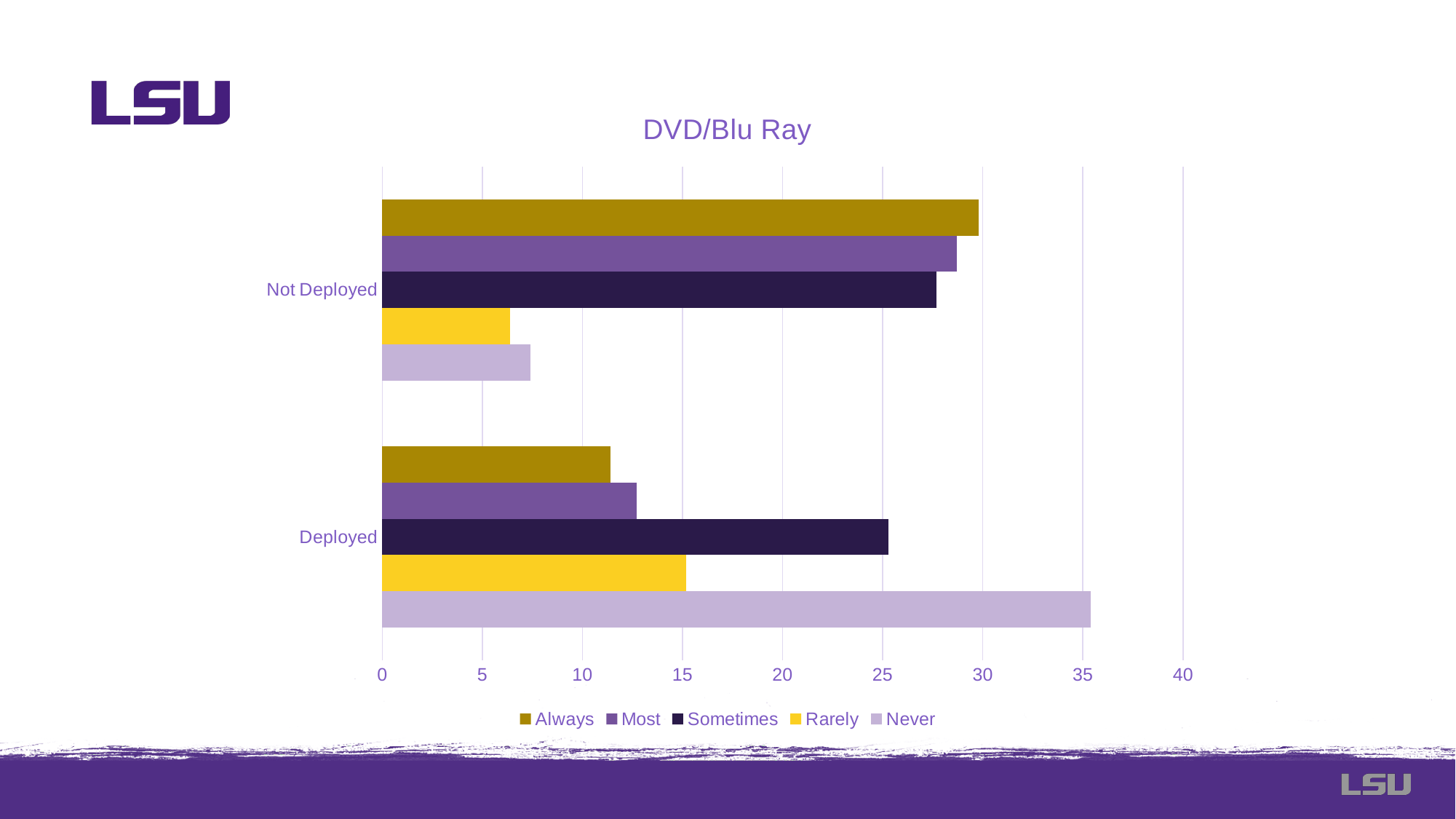
How many categories are shown on the vertical axis? 2 Is the value for Rarely in the Not Deployed category greater or less than 10? less Which series has the longest bar for Not Deployed? Always Which series has the shortest bar for Deployed? Always What is the title of the chart? DVD/Blu Ray Which is larger: the Never value for Deployed or the Never value for Not Deployed? Deployed Which is larger: the Sometimes value for Deployed or the Sometimes value for Not Deployed? Not Deployed Which series has the shortest bar for Not Deployed? Rarely Which series has the longest bar for Deployed? Never How many series does the legend list? 5 What kind of chart is shown on the slide? bar chart